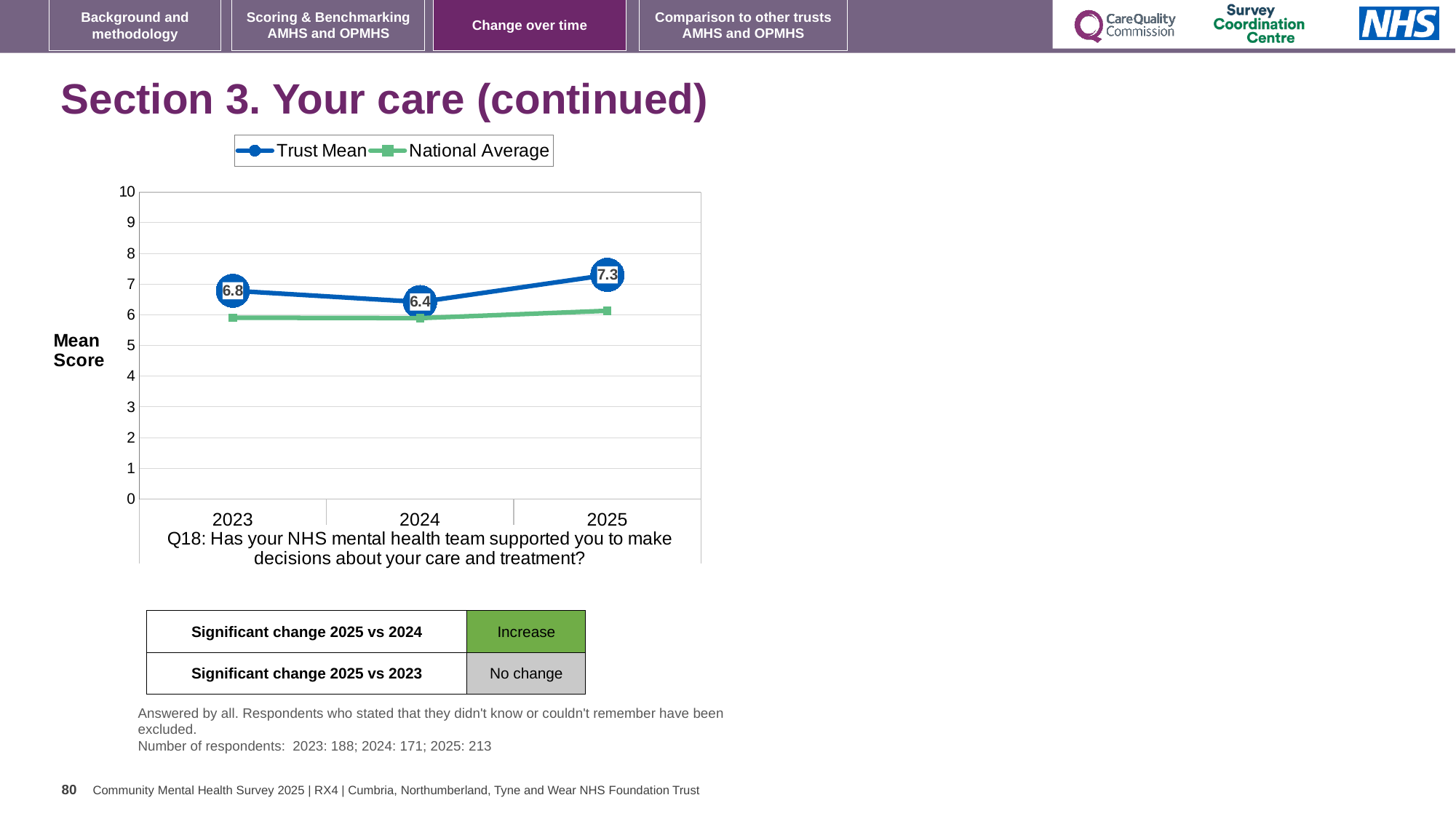
What is the difference between the Trust Mean scores for 2025 and 2024? 0.9 In which year is the Trust Mean score lowest? 2024 What kind of chart is shown on the slide? line chart In 2025, which is larger: the Trust Mean or the National Average? Trust Mean What is the Trust Mean score for 2025? 7.3 In which year is the Trust Mean score highest? 2025 How many years are shown on the x axis of the chart? 3 What is the difference between the Trust Mean scores for 2023 and 2024? 0.4 What is the Trust Mean score for 2024? 6.4 Is the National Average value for 2024 greater or less than 7? less What is the Trust Mean score for 2023? 6.8 How many series does the chart legend list? 2